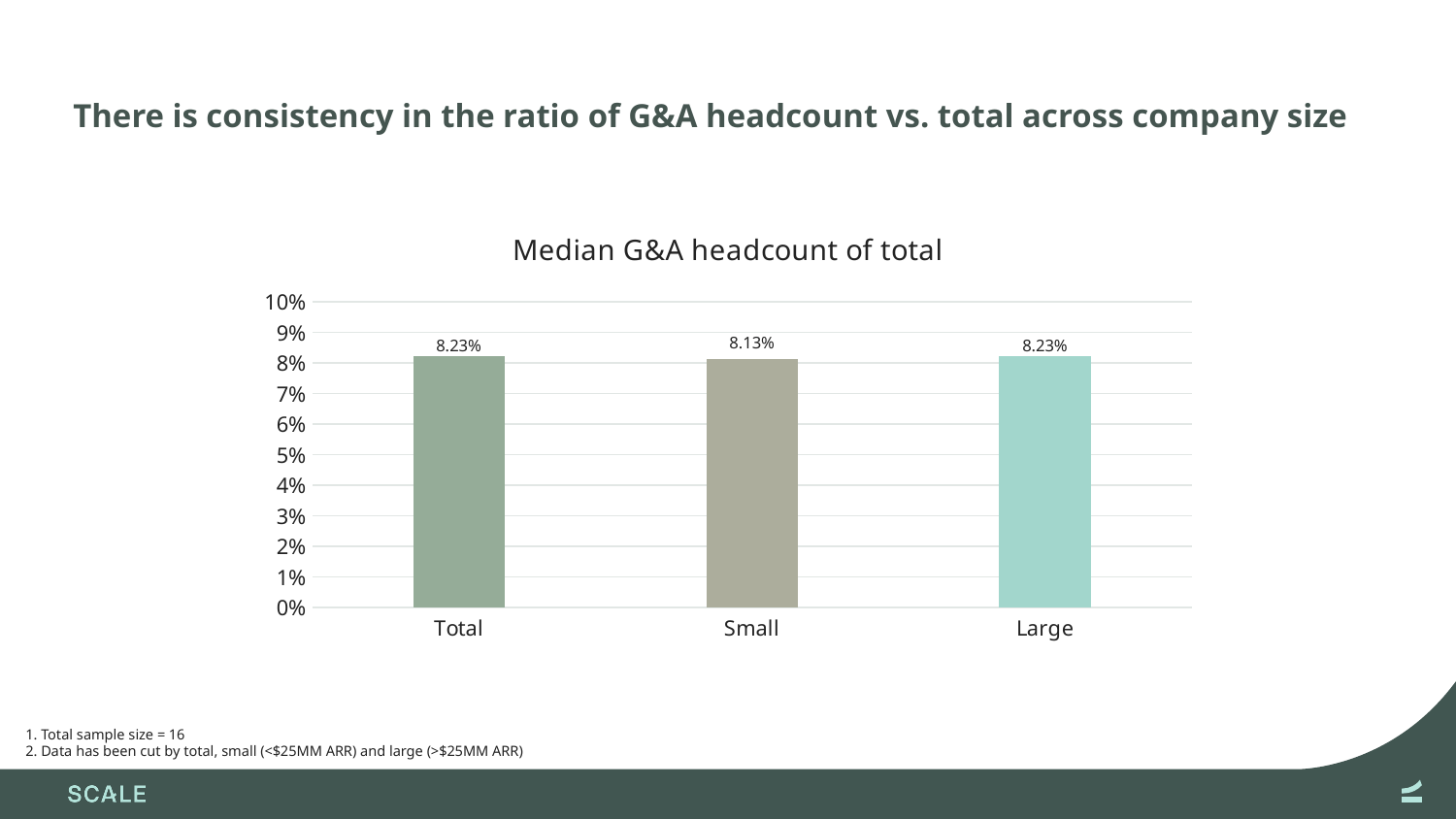
Which is larger, the value for Large or the value for Small? Large What is the highest value shown on the y axis of the chart? 10% How many categories are shown on the x axis of the chart? 3 What is the title of the chart? Median G&A headcount of total What is the value for Total in the Median G&A headcount of total chart? 8.23% What is the value for Large in the chart? 8.23% Is the value for Large greater or less than 9%? less Is the value for Small greater or less than 5%? greater Which category has the lowest median G&A headcount of total? Small What is the difference between the values for Total and Small? 0.10% What kind of chart is shown on the slide? Bar chart What is the value for Small in the chart? 8.13%